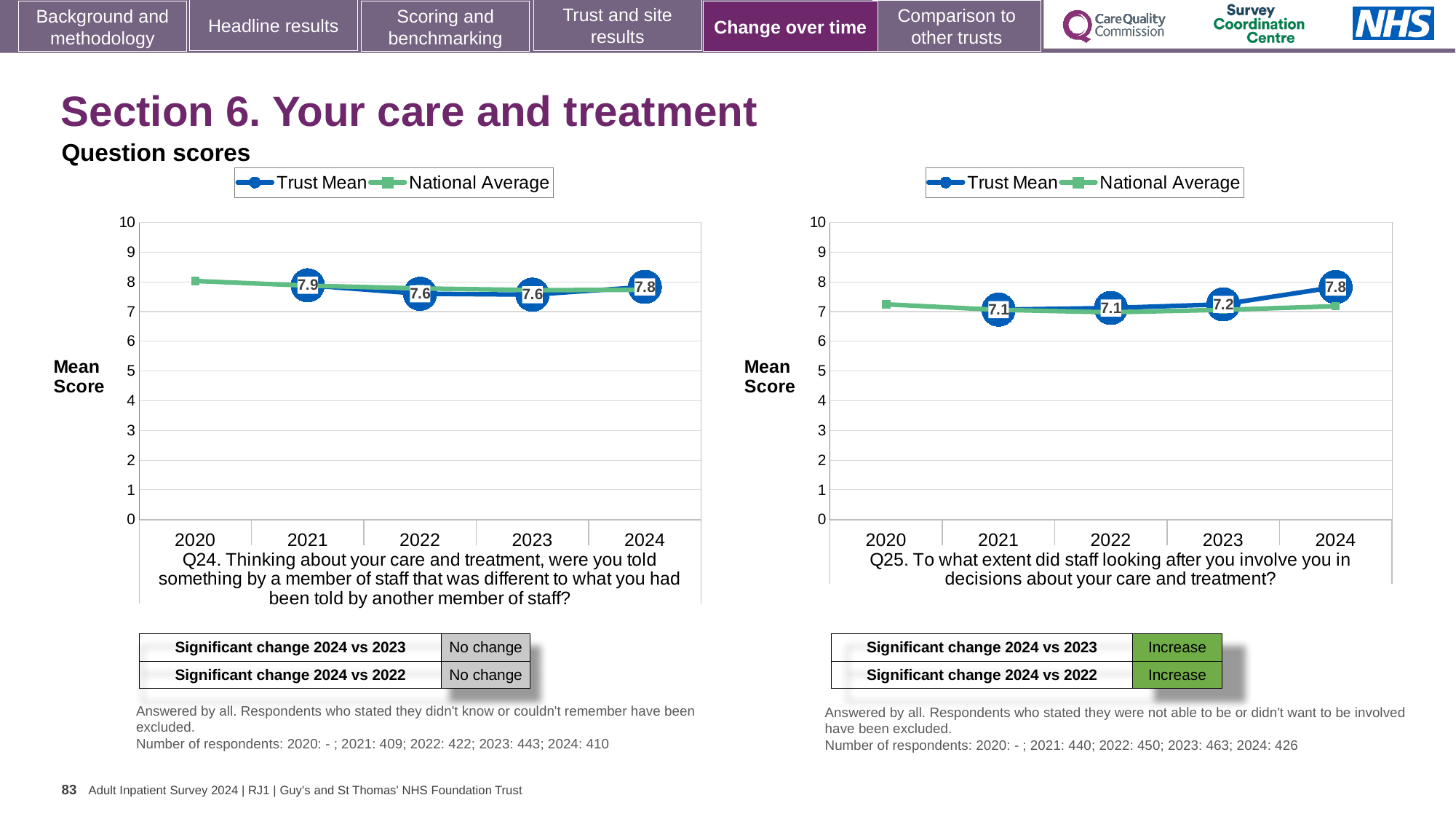
How many years are shown on the x axis of the Q24 chart on the left? 5 What type of chart is used for the Q24 question scores on the left? Line chart How many series does the legend of the Q25 chart on the right list? 2 In the Q24 chart on the left, what is the Trust Mean score for 2021? 7.9 In the Q24 chart on the left, what is the Trust Mean score for 2024? 7.8 In the Q25 chart on the right, which year has the highest Trust Mean score? 2024 In the Q25 chart on the right, does the Trust Mean score rise or fall from 2021 to 2024? Rise In the Q24 chart on the left, which year has the highest Trust Mean score? 2021 In the Q24 chart on the left, is the Trust Mean score higher in 2021 or in 2022? 2021 In the Q25 chart on the right, what is the Trust Mean score for 2023? 7.2 In the Q25 chart on the right, is the National Average value for 2024 greater or less than 8? less In the Q25 chart on the right, what is the difference between the Trust Mean scores for 2024 and 2023? 0.6